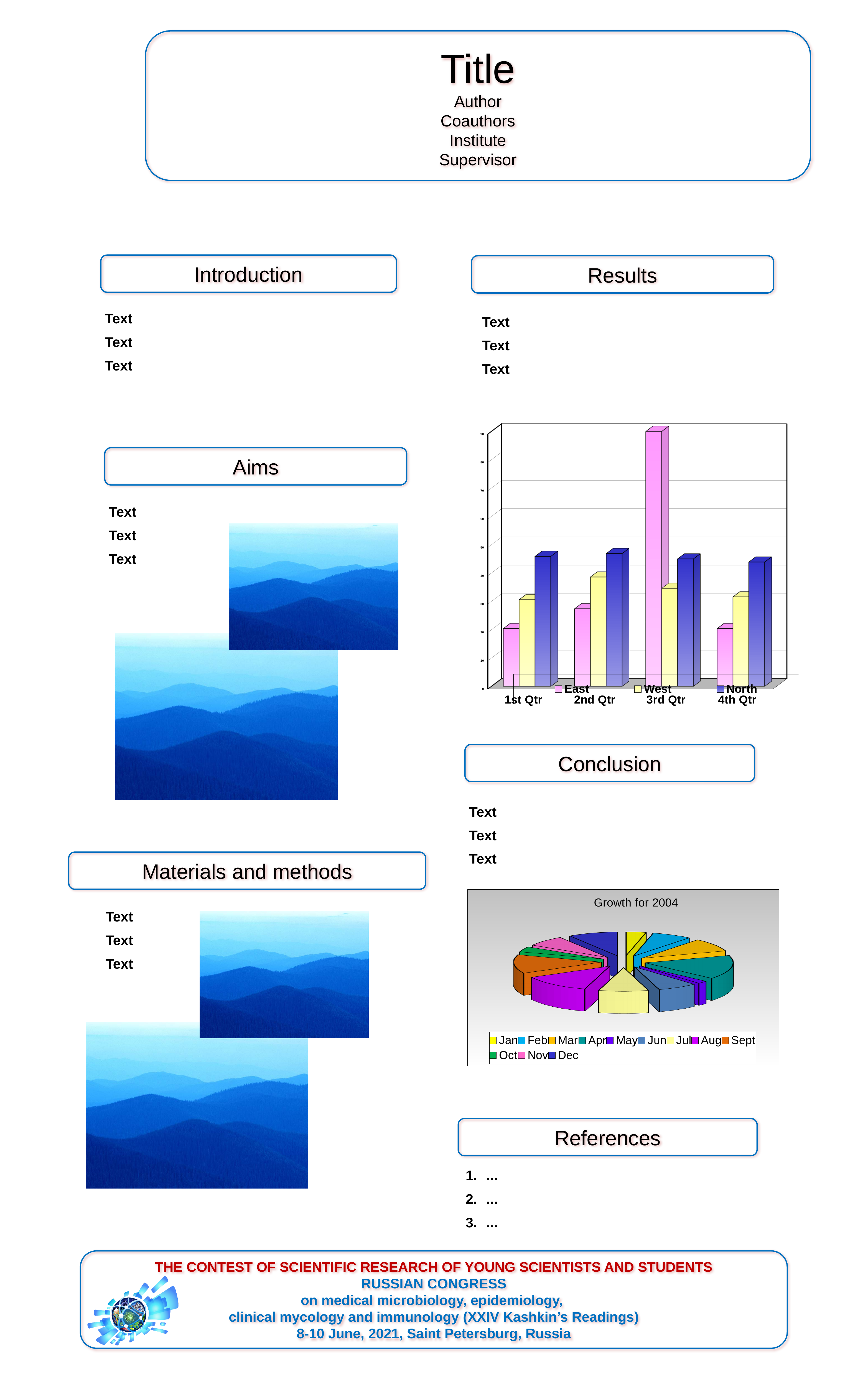
In the Results bar chart, is the East value for 3rd Qtr greater or less than 80? greater In the Results bar chart, is the West value for 1st Qtr greater or less than 40? less In the Results bar chart, which is larger for 1st Qtr: North or East? North In the Results bar chart, in which quarter is the East series highest? 3rd Qtr What kind of chart is shown in the Results section? bar chart In the Results bar chart, how many series does the legend list? 3 In the Results bar chart, how many quarter categories are shown on the x axis? 4 In the Results bar chart, which is larger for 3rd Qtr: East or West? East What kind of chart is shown in the Conclusion section? pie chart What is the title of the pie chart in the Conclusion section? Growth for 2004 In the Results bar chart, is the North value for 1st Qtr greater or less than 40? greater In the Growth for 2004 pie chart, how many slices does the legend list? 12